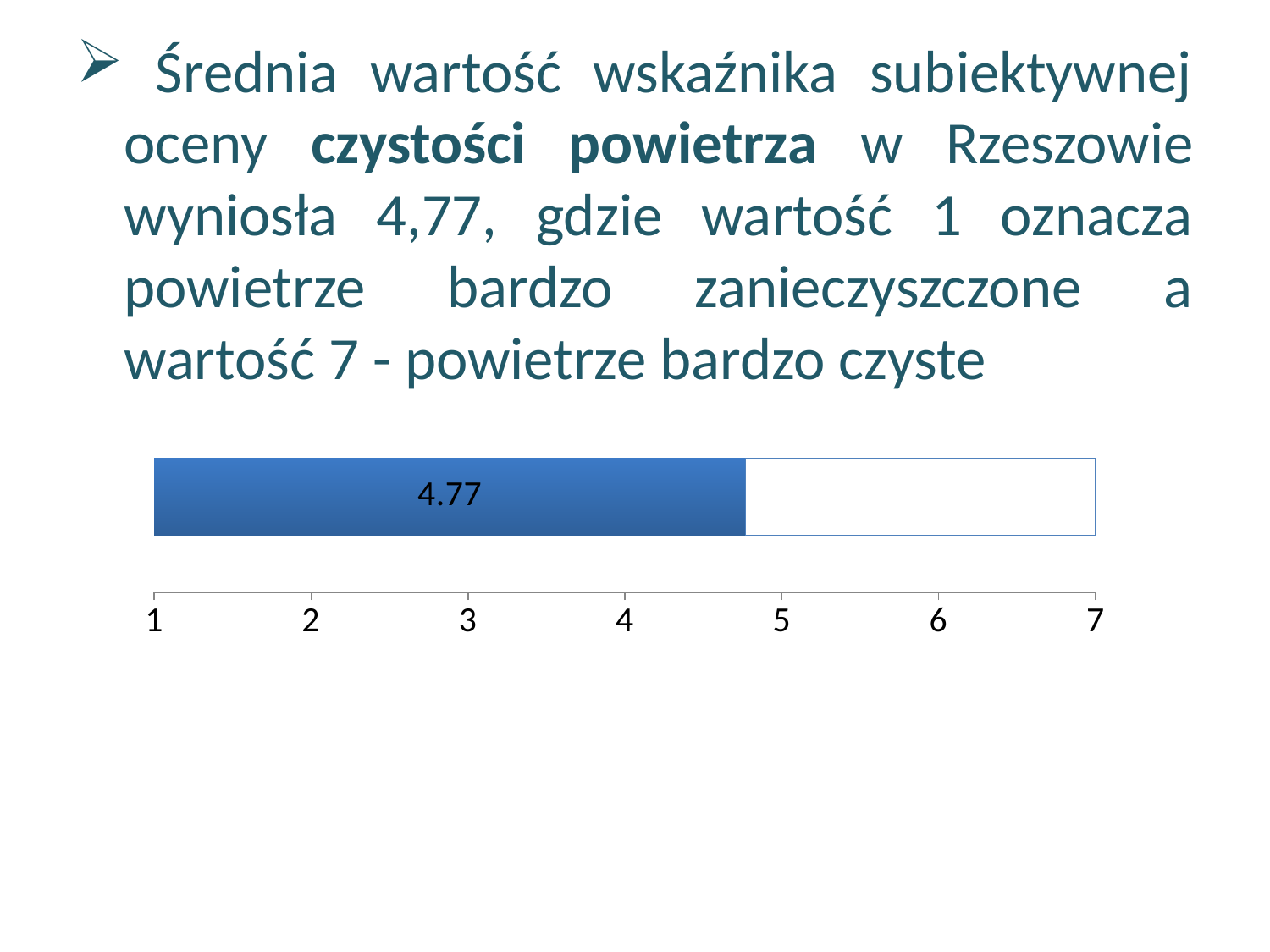
Is the value of the bar greater or less than 4? greater What is the highest tick value shown on the horizontal axis of the chart? 7 Is the value of the bar greater or less than 5? less What value is printed on the bar in the chart? 4.77 Is the bar in the chart oriented horizontally or vertically? horizontally What is the lowest tick value shown on the horizontal axis of the chart? 1 What kind of chart is shown on the slide? bar chart